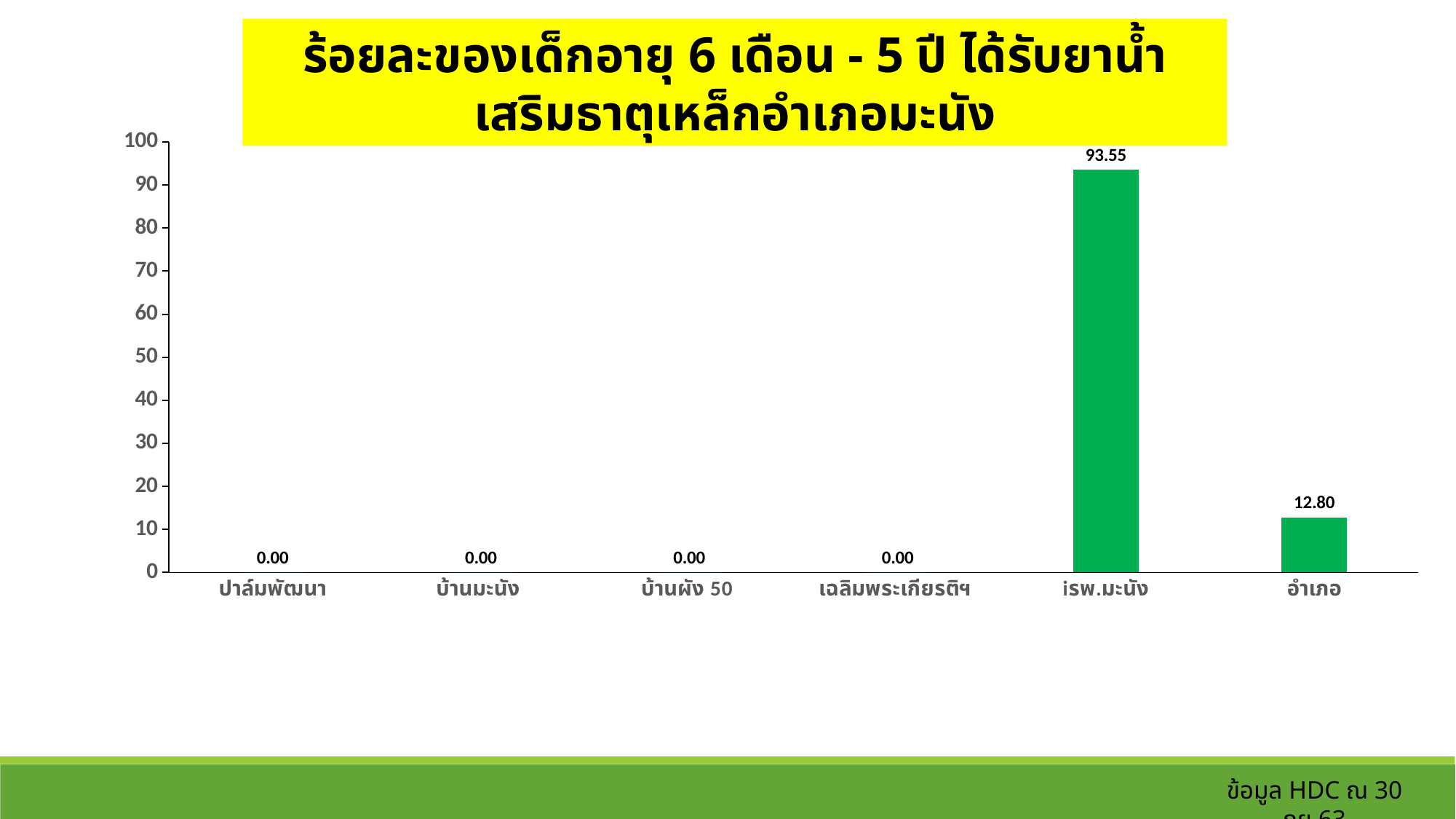
How many categories have a value of 0.00? 4 What is the value for อำเภอ? 12.80 How many categories are shown on the x axis? 6 What is the difference between the values for รพ.มะนัง and อำเภอ? 80.75 Which category has the highest value? iรพ.มะนัง What is the value for รพ.มะนัง? 93.55 What kind of chart is shown on the slide? bar chart Is the value for อำเภอ greater or less than 20? less What is the value for ปาล์มพัฒนา? 0.00 Is the value for รพ.มะนัง greater or less than 90? greater Which is larger, the value for อำเภอ or the value for บ้านมะนัง? อำเภอ What is the value for เฉลิมพระเกียรติฯ? 0.00